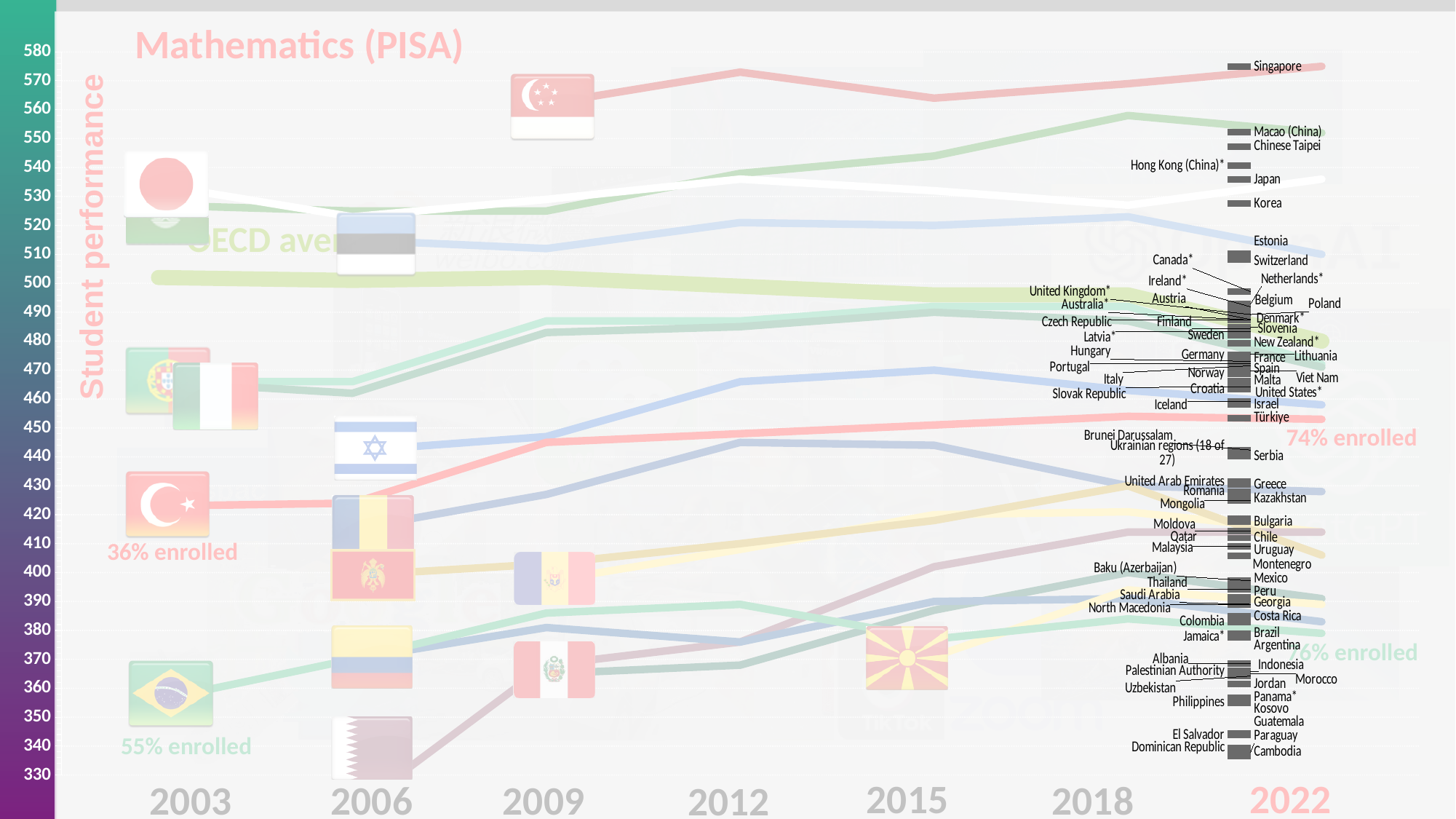
Is Singapore's value in 2022 greater or less than 570? greater In 2022, which has the higher student performance, Japan or Korea? Japan Does Türkiye's student performance rise or fall from 2003 to 2022? rise What is the label on the vertical axis of the chart? Student performance Is Japan's value in 2022 greater or less than 530? greater How many years are marked along the x axis of the chart? 7 Which country has the highest student performance in 2022? Singapore Which country has the lowest student performance in 2022? Cambodia Is Brazil's value in 2003 greater or less than 360? less What is the title of the chart? Mathematics (PISA) What kind of chart is shown on the slide? line chart